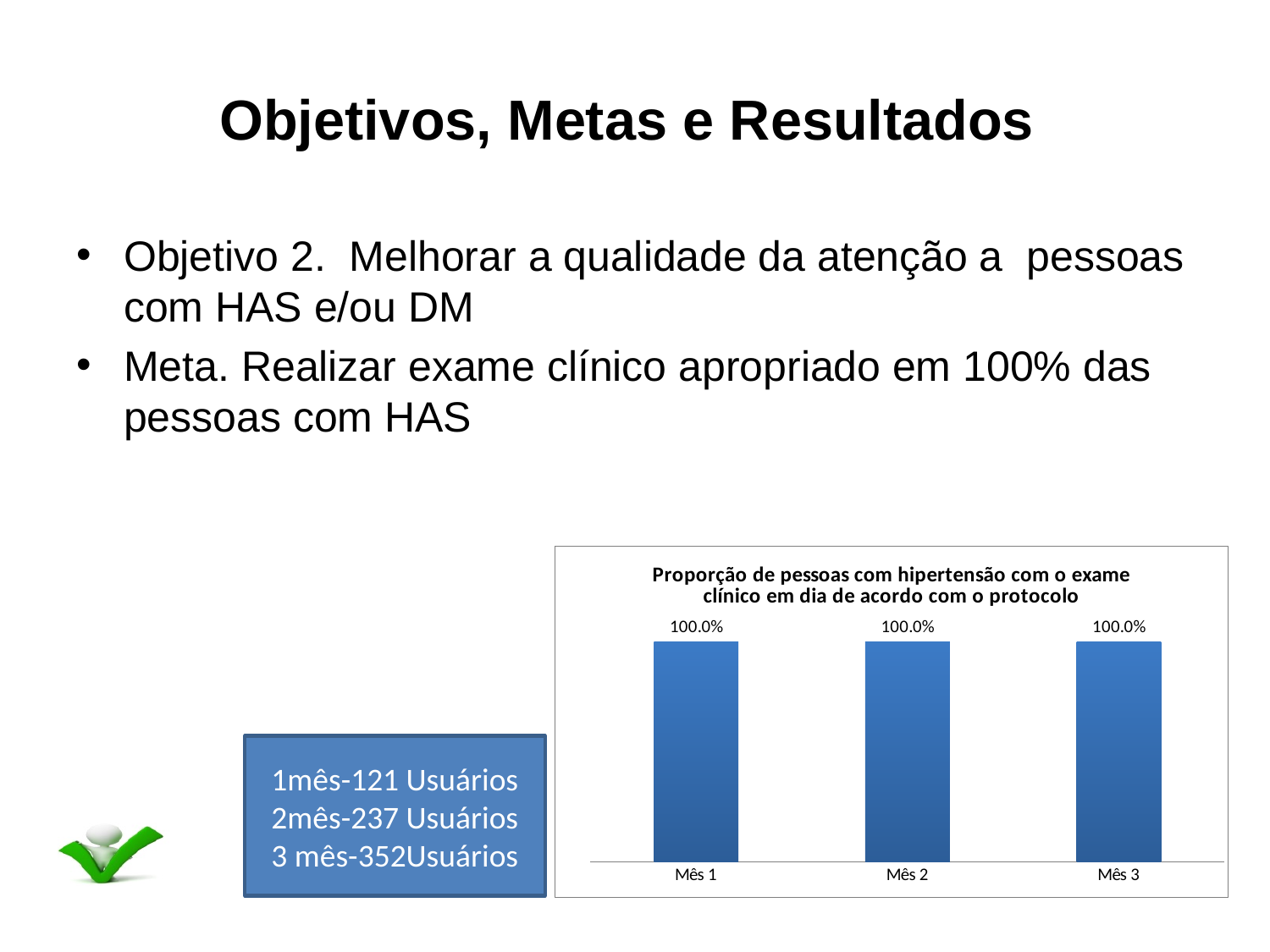
What is the value for Mês 1 in the chart? 100.0% How many categories are shown on the x axis of the chart? 3 Do the values rise, fall or stay the same from Mês 1 to Mês 3? Stay the same What kind of chart is shown on the slide? Bar chart What is the value for Mês 2 in the chart? 100.0% What is the difference between the values for Mês 1 and Mês 3? 0.0% What is the title of the chart? Proporção de pessoas com hipertensão com o exame clínico em dia de acordo com o protocolo What is the value for Mês 3 in the chart? 100.0% Which category is labelled on the far right of the x axis? Mês 3 What colour are the bars in the chart? Blue